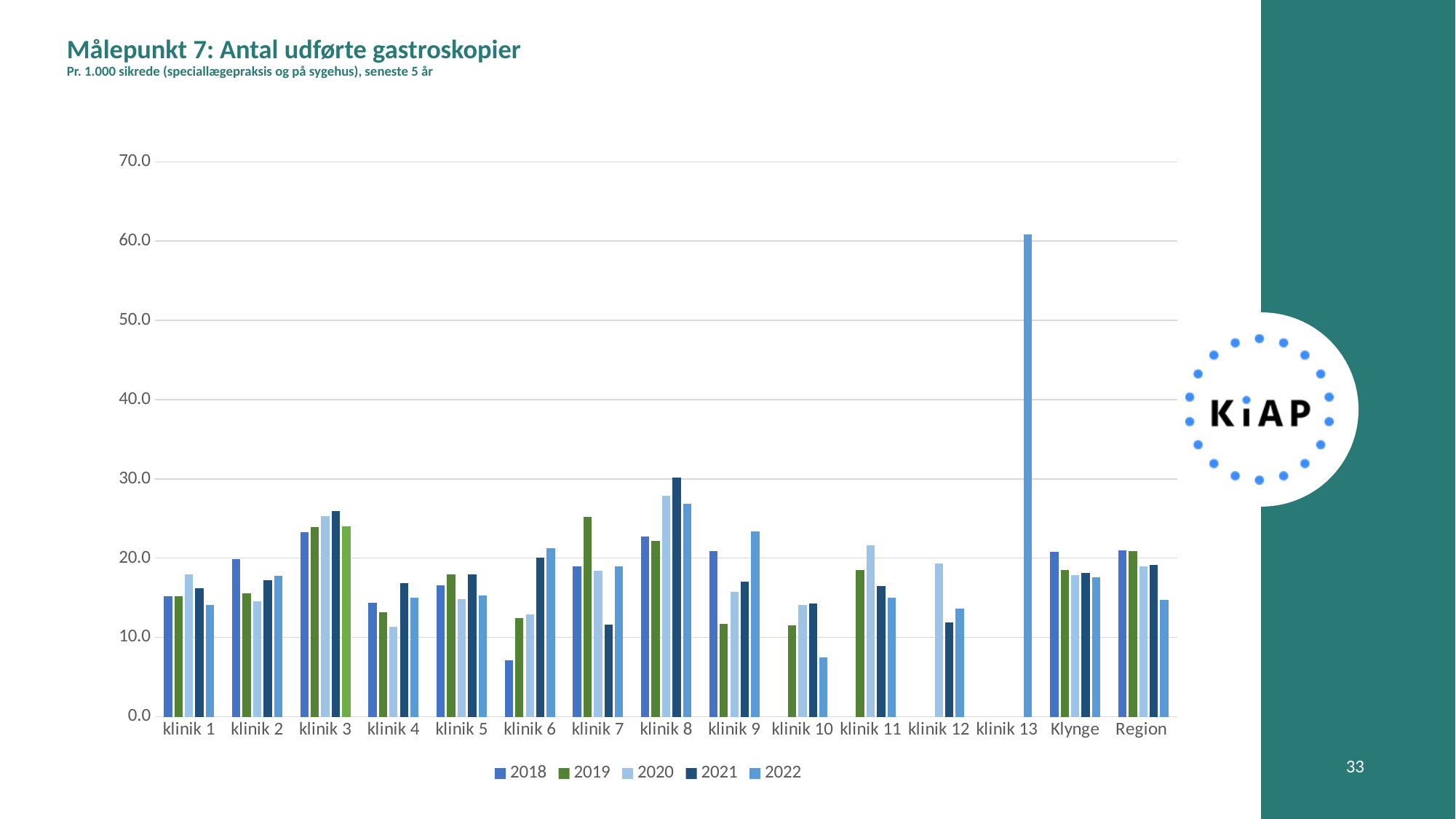
How many categories are shown along the x axis? 15 Is the 2022 value for klinik 13 greater or less than 50? greater Is the 2018 value for klinik 6 greater or less than 10? less Which category has the highest bar in the chart? klinik 13 Is the 2022 value for klinik 10 greater or less than 10? less What is the title of the chart? Målepunkt 7: Antal udførte gastroskopier How many series does the legend list? 5 Which is larger for 2021: klinik 8 or klinik 1? klinik 8 Which series is shown in green in the legend? 2019 Which is larger for klinik 7: the 2019 value or the 2021 value? 2019 What kind of chart is shown on the slide? bar chart